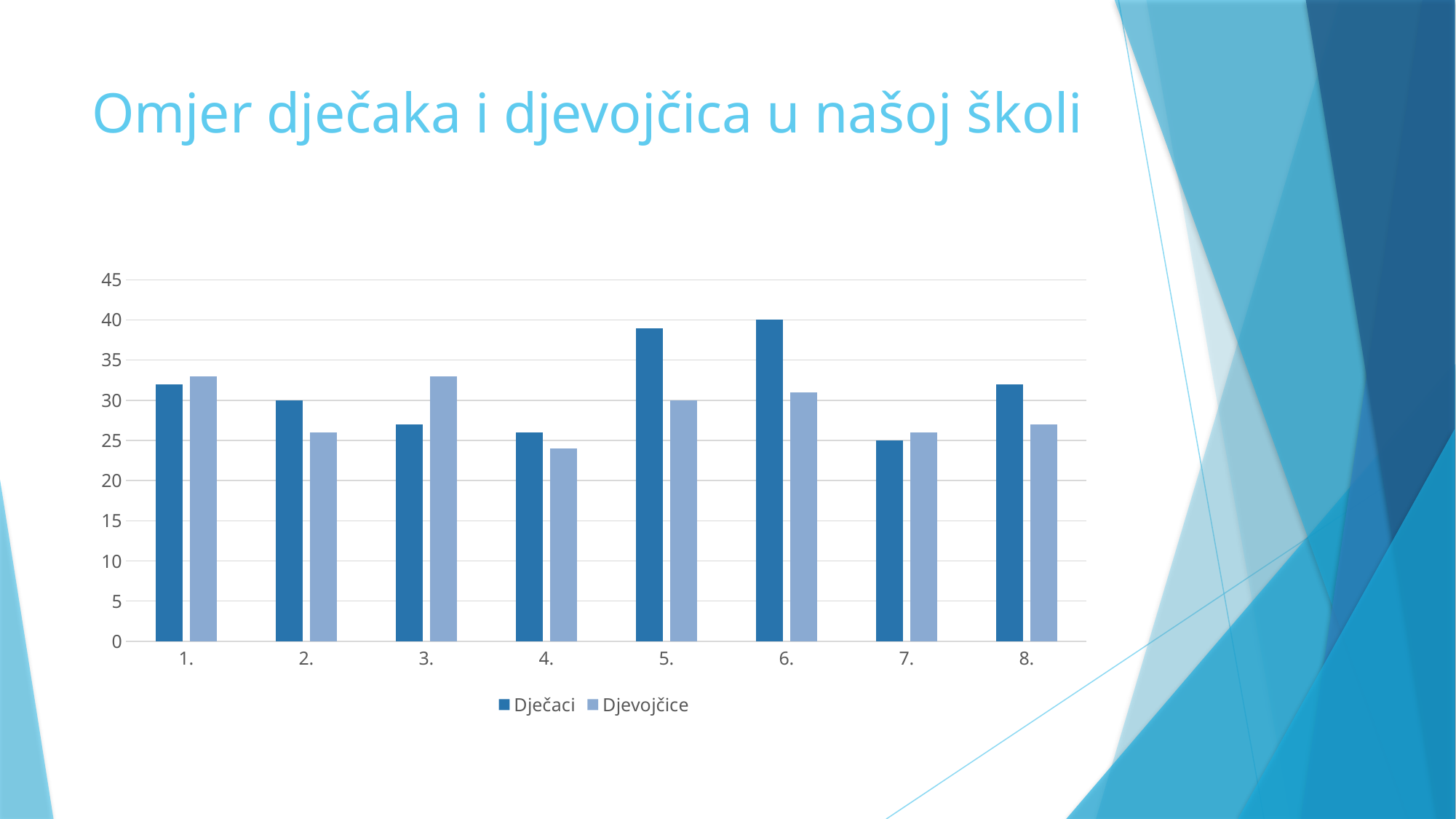
Is the value for Dječaci in category 5. greater or less than 35? greater In category 5., which series has the larger value, Dječaci or Djevojčice? Dječaci What kind of chart is shown on the slide? bar chart How many series does the legend list? 2 What is the title of the slide? Omjer dječaka i djevojčica u našoj školi Which series is shown in the darker blue bars? Dječaci Is the value for Dječaci in category 3. greater or less than 30? less What is the value for Dječaci in category 2.? 30 Is the value for Djevojčice in category 4. greater or less than 25? less What is the value for Dječaci in category 6.? 40 In category 3., which series has the larger value, Dječaci or Djevojčice? Djevojčice How many categories are shown on the x axis? 8